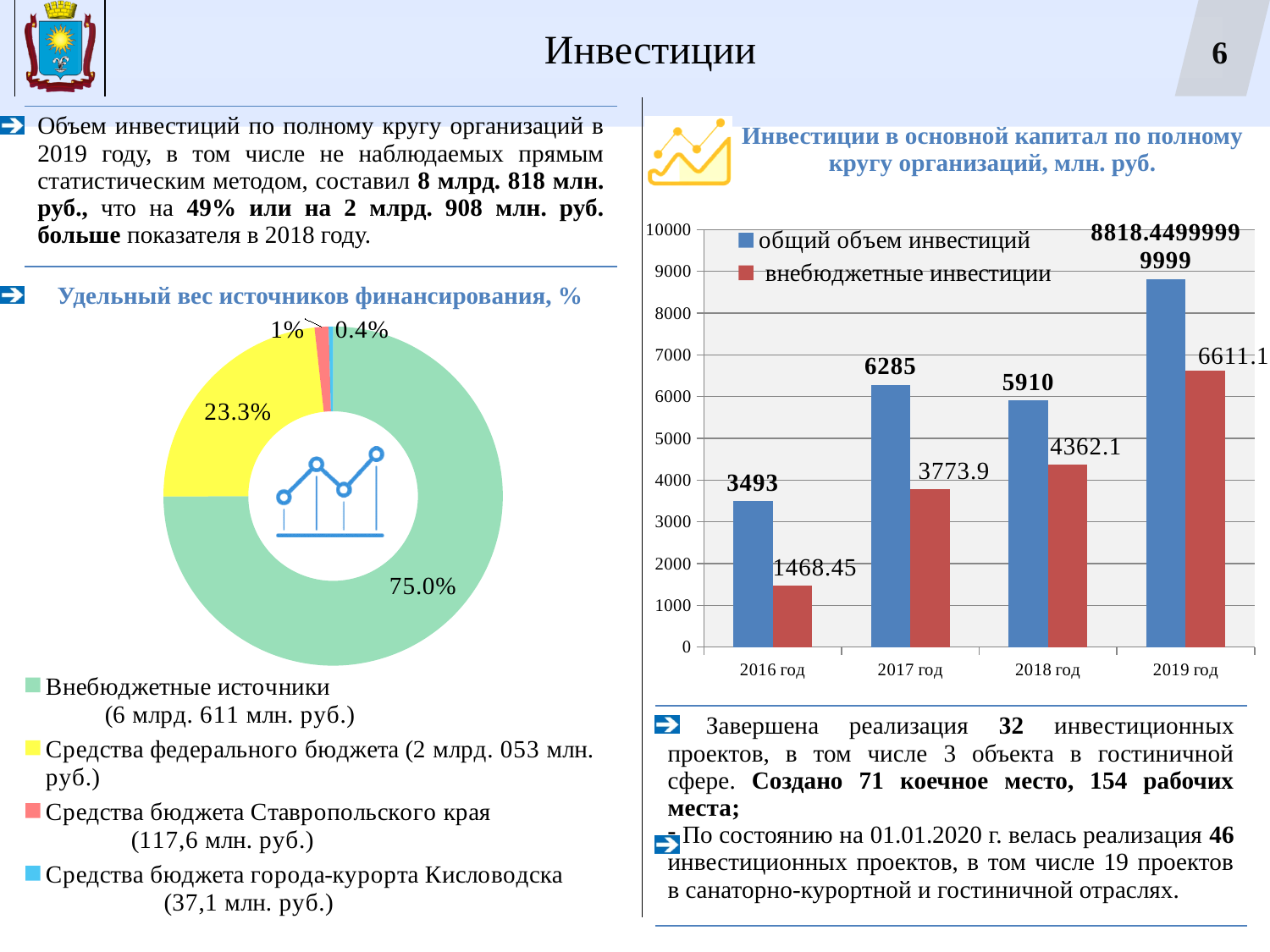
In the chart 'Удельный вес источников финансирования, %', what share do Внебюджетные источники have? 75.0% In the bar chart 'Инвестиции в основной капитал по полному кругу организаций, млн. руб.', do the values of внебюджетные инвестиции rise or fall from 2016 год to 2019 год? rise In the chart 'Удельный вес источников финансирования, %', what share do Средства федерального бюджета have? 23.3% In the bar chart 'Инвестиции в основной капитал по полному кругу организаций, млн. руб.', which year has the lowest общий объем инвестиций? 2016 год In the bar chart 'Инвестиции в основной капитал по полному кругу организаций, млн. руб.', which is larger: внебюджетные инвестиции in 2017 год or in 2018 год? 2018 год In the bar chart 'Инвестиции в основной капитал по полному кругу организаций, млн. руб.', is the value of общий объем инвестиций for 2019 год greater or less than 8000? greater In the bar chart 'Инвестиции в основной капитал по полному кругу организаций, млн. руб.', what is the difference between общий объем инвестиций in 2017 год and 2018 год? 375 In the bar chart 'Инвестиции в основной капитал по полному кругу организаций, млн. руб.', what is the value of внебюджетные инвестиции for 2019 год? 6611.1 In the bar chart 'Инвестиции в основной капитал по полному кругу организаций, млн. руб.', what is the value of внебюджетные инвестиции for 2016 год? 1468.45 What kind of chart is 'Удельный вес источников финансирования, %'? doughnut chart In the bar chart 'Инвестиции в основной капитал по полному кругу организаций, млн. руб.', what is the value of общий объем инвестиций for 2017 год? 6285 In the bar chart 'Инвестиции в основной капитал по полному кругу организаций, млн. руб.', how many series does the legend list? 2